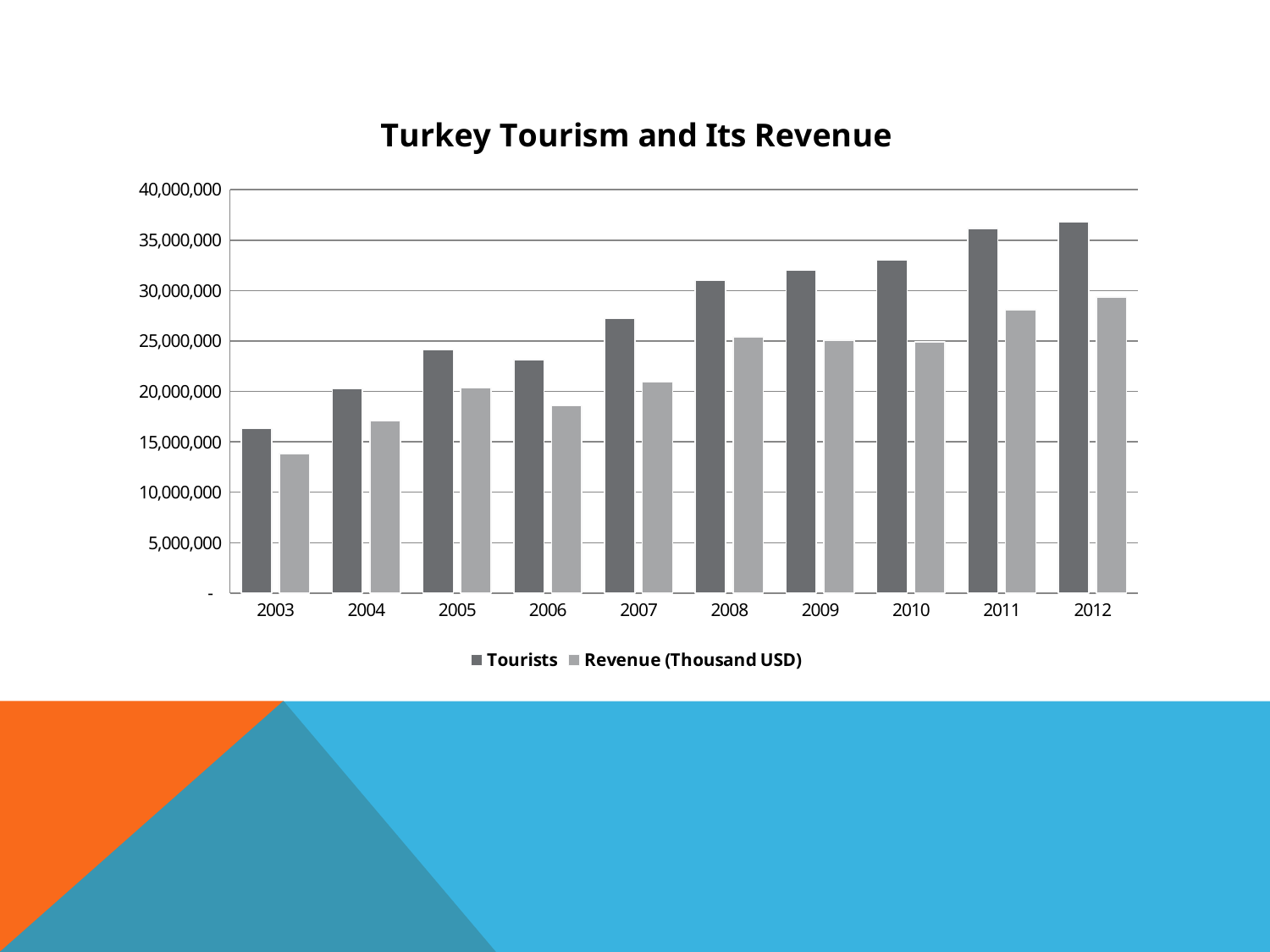
Is the Tourists value for 2011 greater or less than 35,000,000? greater How many series does the legend list? 2 Is the Tourists value for 2003 greater or less than 15,000,000? greater Which year has the highest Revenue (Thousand USD) value? 2012 Is the Revenue (Thousand USD) value for 2004 greater or less than 20,000,000? less Which year has the lowest Tourists value? 2003 What kind of chart is shown on the slide? Bar chart Do the Tourists values generally rise or fall from 2003 to 2012? rise What is the title of the chart? Turkey Tourism and Its Revenue How many years are shown on the x axis? 10 Which is larger, the Tourists value for 2005 or for 2006? 2005